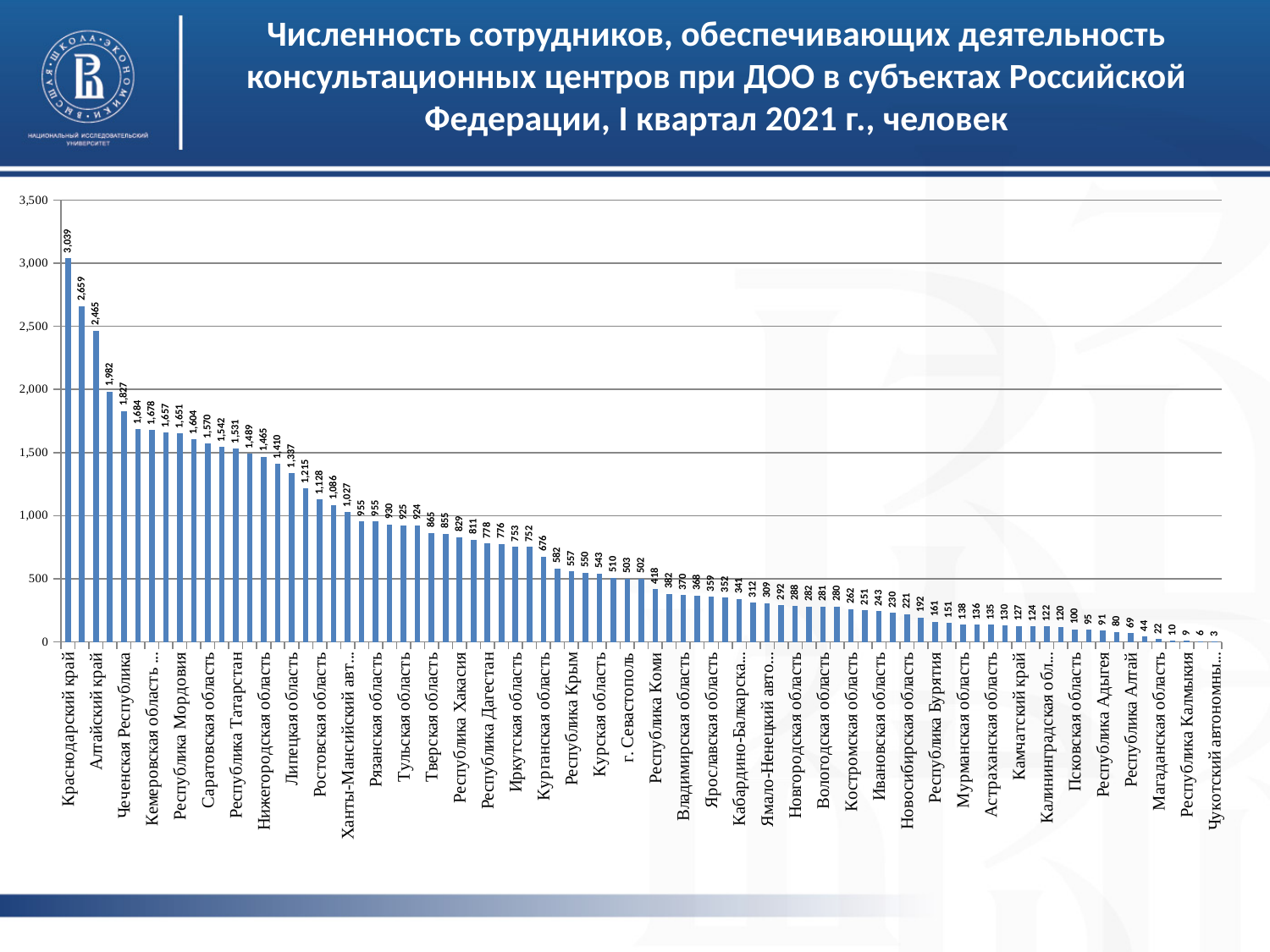
What is the value for Краснодарский край? 3,039 Which is larger, the value for Тульская область or Тверская область? Тульская область Is the value for Республика Коми greater or less than 500? less What is the value for Республика Татарстан? 1,531 What type of chart is shown on the slide? bar chart Do the values rise or fall from left to right along the x axis? fall Which region has the highest number of employees? Краснодарский край What is the value for Республика Коми? 418 What is the value for Рязанская область? 955 What is the value for Алтайский край? 2,465 What is the difference between the values for Краснодарский край and Алтайский край? 574 What is the value for Псковская область? 100